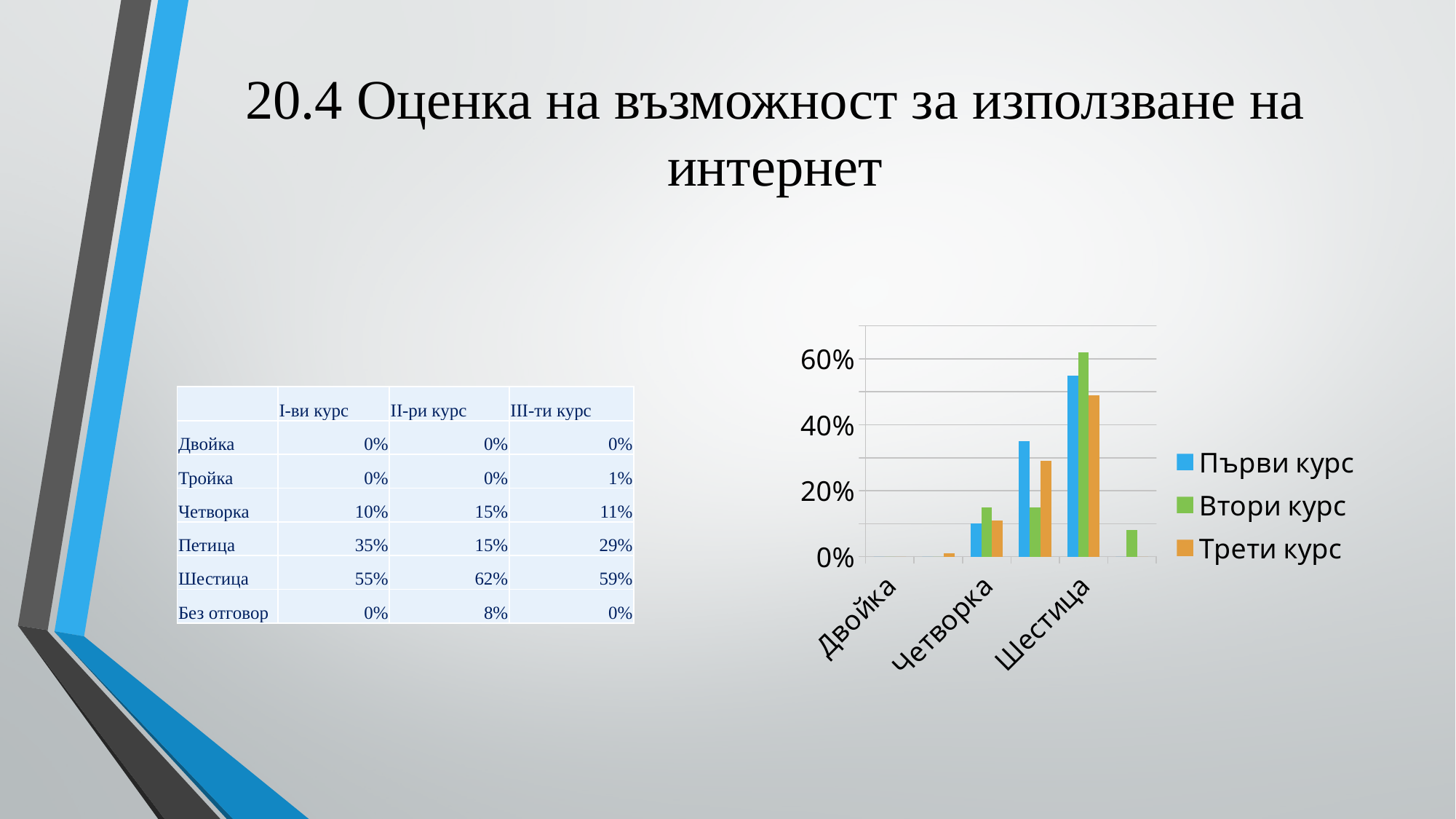
What are the three series named in the chart's legend? Първи курс, Втори курс, Трети курс Is the value for Трети курс at Шестица greater or less than 60%? less Is the value for Втори курс at Четворка greater or less than 20%? less According to the slide, what is the value for Първи курс at Четворка? 10% For Четворка, which is larger: the bar for Първи курс or the bar for Втори курс? Втори курс Which series has the lowest bar for Шестица in the chart? Трети курс Is the value for Първи курс at Шестица greater or less than 40%? greater According to the slide, what is the value for Втори курс at Шестица? 62% Which series has the highest bar for Шестица? Втори курс Which colour represents Втори курс in the chart? green How many series does the chart's legend list? 3 What kind of chart is shown on the slide? bar chart